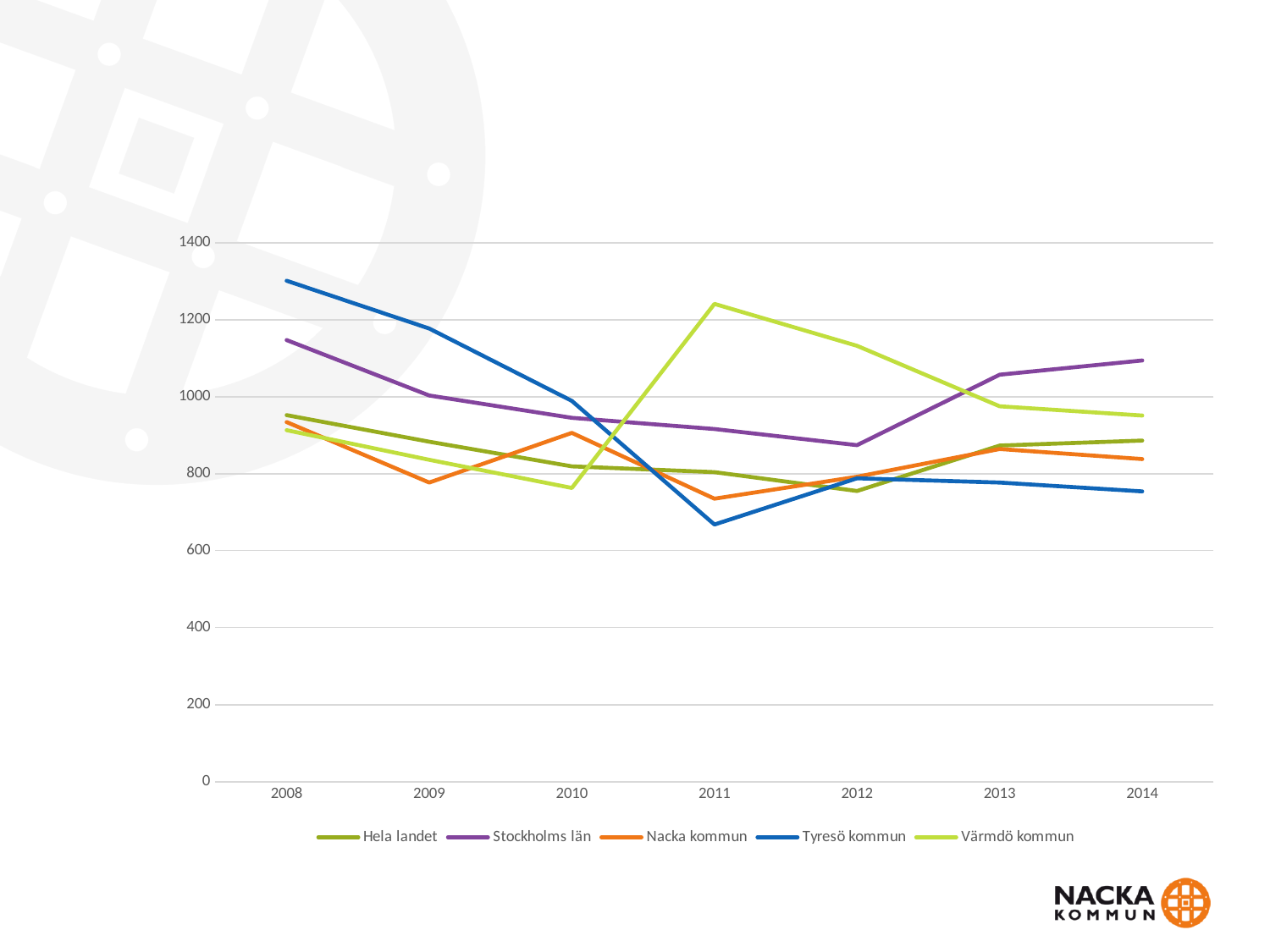
Does the value for Tyresö kommun rise or fall from 2008 to 2011? fall Is the value for Tyresö kommun in 2008 greater or less than 1200? greater How many series does the legend list? 5 What kind of chart is shown on the slide? line chart How many years are shown along the x axis? 7 Which series has the highest value in 2008? Tyresö kommun Which series has the highest value in 2014? Stockholms län Which series has the lowest value in 2011? Tyresö kommun In 2014, which is larger: the value for Stockholms län or the value for Tyresö kommun? Stockholms län Is the value for Värmdö kommun in 2011 greater or less than 1200? greater Is the value for Tyresö kommun in 2011 greater or less than 800? less Which series has the highest value in 2011? Värmdö kommun